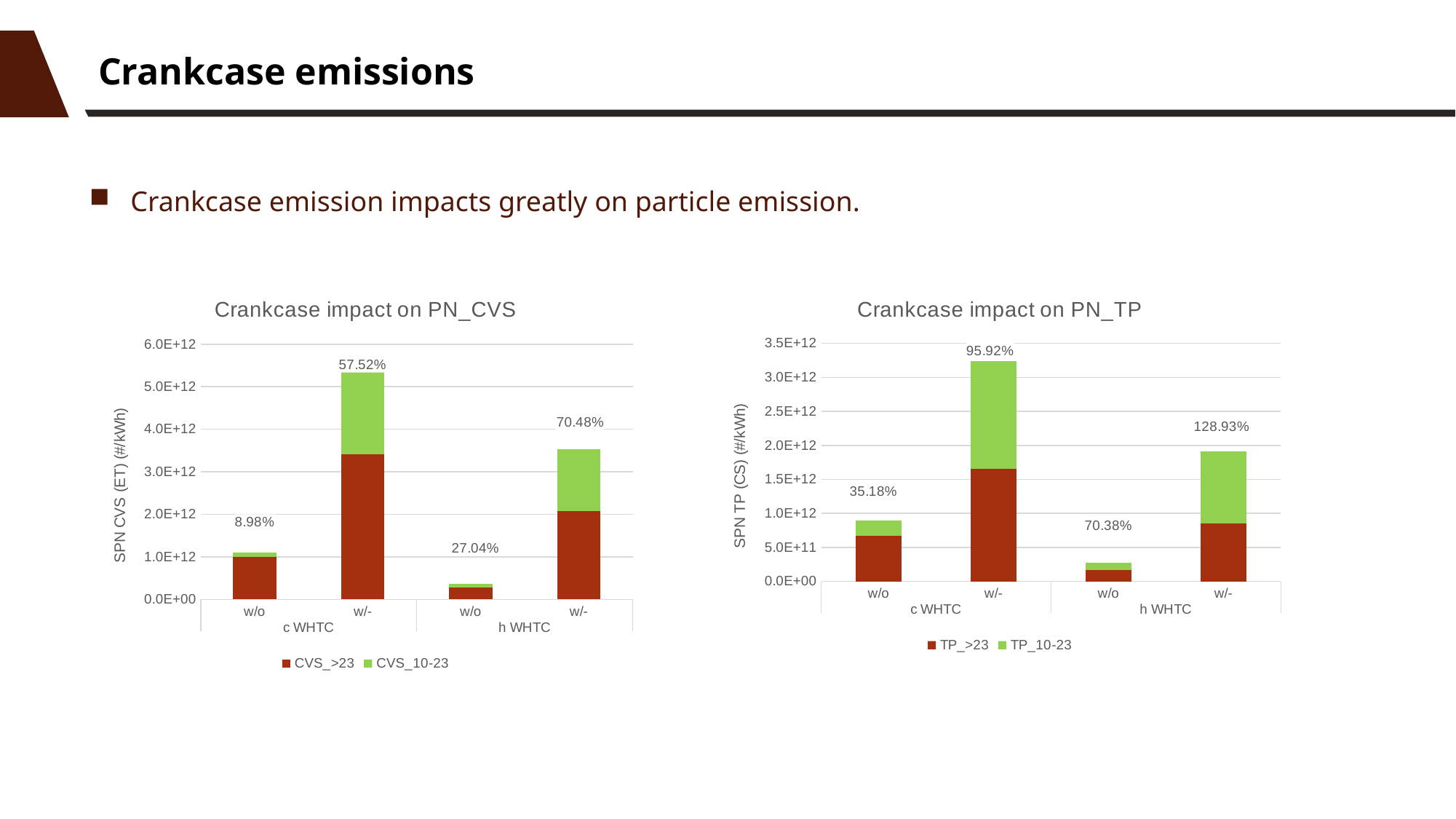
In the 'Crankcase impact on PN_TP' chart, what percentage label is shown above the w/- bar under h WHTC? 128.93% In the 'Crankcase impact on PN_CVS' chart, which bar has the lowest percentage label? w/o under c WHTC In the 'Crankcase impact on PN_TP' chart, is the total height of the w/- bar under h WHTC greater or less than 2.0E+12? less How many series does the legend of the 'Crankcase impact on PN_CVS' chart list? 2 In the 'Crankcase impact on PN_TP' chart, which bar has the highest percentage label? w/- under h WHTC In the 'Crankcase impact on PN_CVS' chart, what percentage label is shown above the w/- bar under c WHTC? 57.52% What is the y-axis label of the 'Crankcase impact on PN_TP' chart? SPN TP (CS) (#/kWh) In the 'Crankcase impact on PN_CVS' chart, what percentage label is shown above the w/o bar under h WHTC? 27.04% What type of chart is 'Crankcase impact on PN_TP'? Stacked bar chart In the 'Crankcase impact on PN_CVS' chart, which bar is taller: w/- under c WHTC or w/- under h WHTC? w/- under c WHTC In the 'Crankcase impact on PN_TP' chart, what percentage label is shown above the w/o bar under c WHTC? 35.18% In the 'Crankcase impact on PN_TP' chart, is the total height of the w/- bar under c WHTC greater or less than 3.0E+12? greater